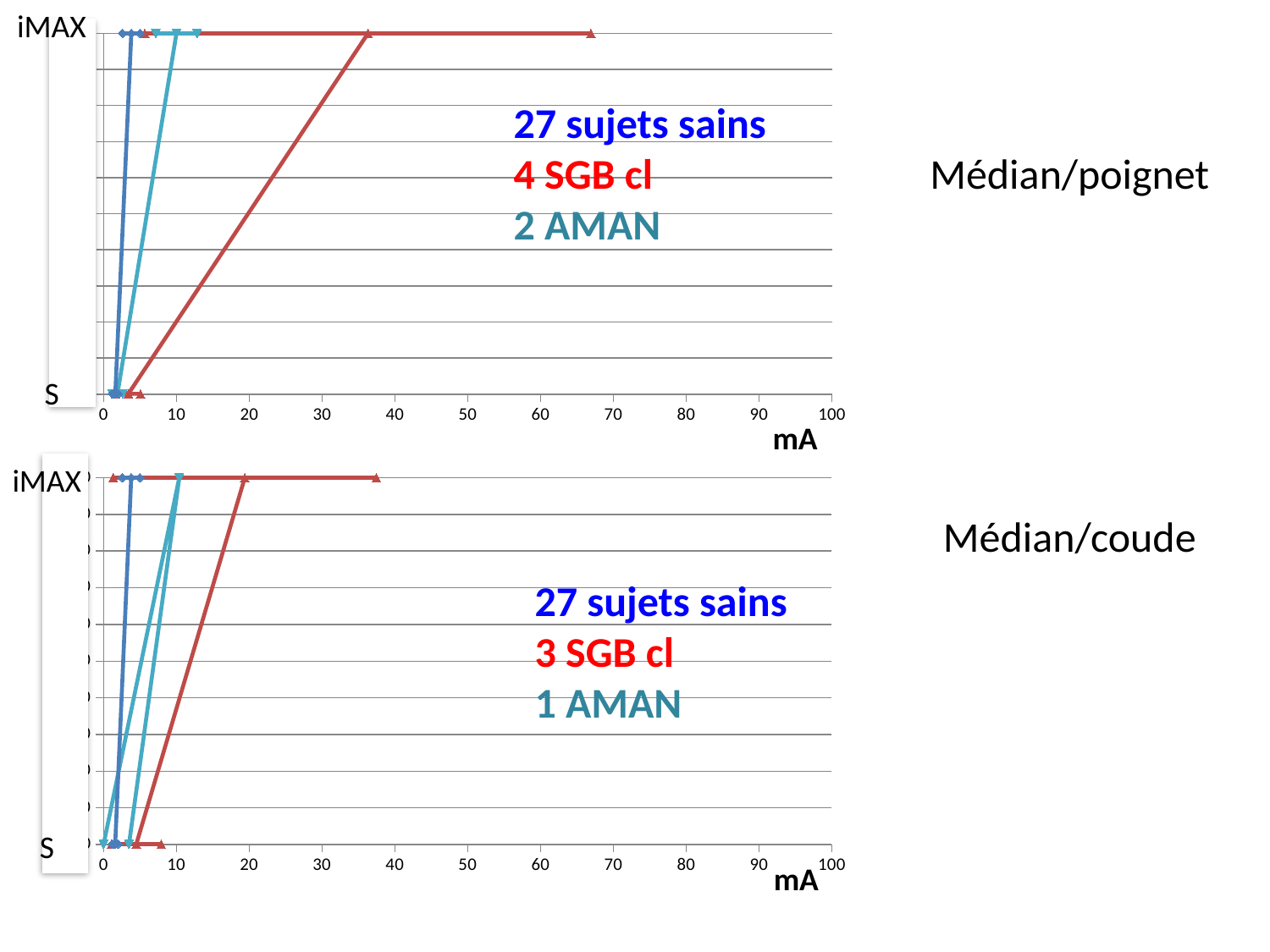
How many SGB cl subjects are listed for the Médian/coude chart? 3 What is the maximum value shown on the x axis of the Médian/coude chart? 100 In the Médian/coude chart, is the largest iMAX value reached by the red SGB cl lines greater or less than 40 mA? less In the Médian/poignet chart, is the largest iMAX value reached by the red SGB cl lines greater or less than 60 mA? greater In the Médian/coude chart, is the largest iMAX value reached by the red SGB cl lines greater or less than 30 mA? greater In the Médian/poignet chart, which group reaches the highest mA value at iMAX: sujets sains, SGB cl or AMAN? SGB cl What kind of chart is the Médian/poignet chart at the top of the slide? line chart What unit is shown on the x axis of both charts? mA In the Médian/poignet chart, which reaches a larger mA value at iMAX: the SGB cl lines or the AMAN lines? SGB cl In the Médian/coude chart, which group reaches the highest mA value at iMAX: sujets sains, SGB cl or AMAN? SGB cl